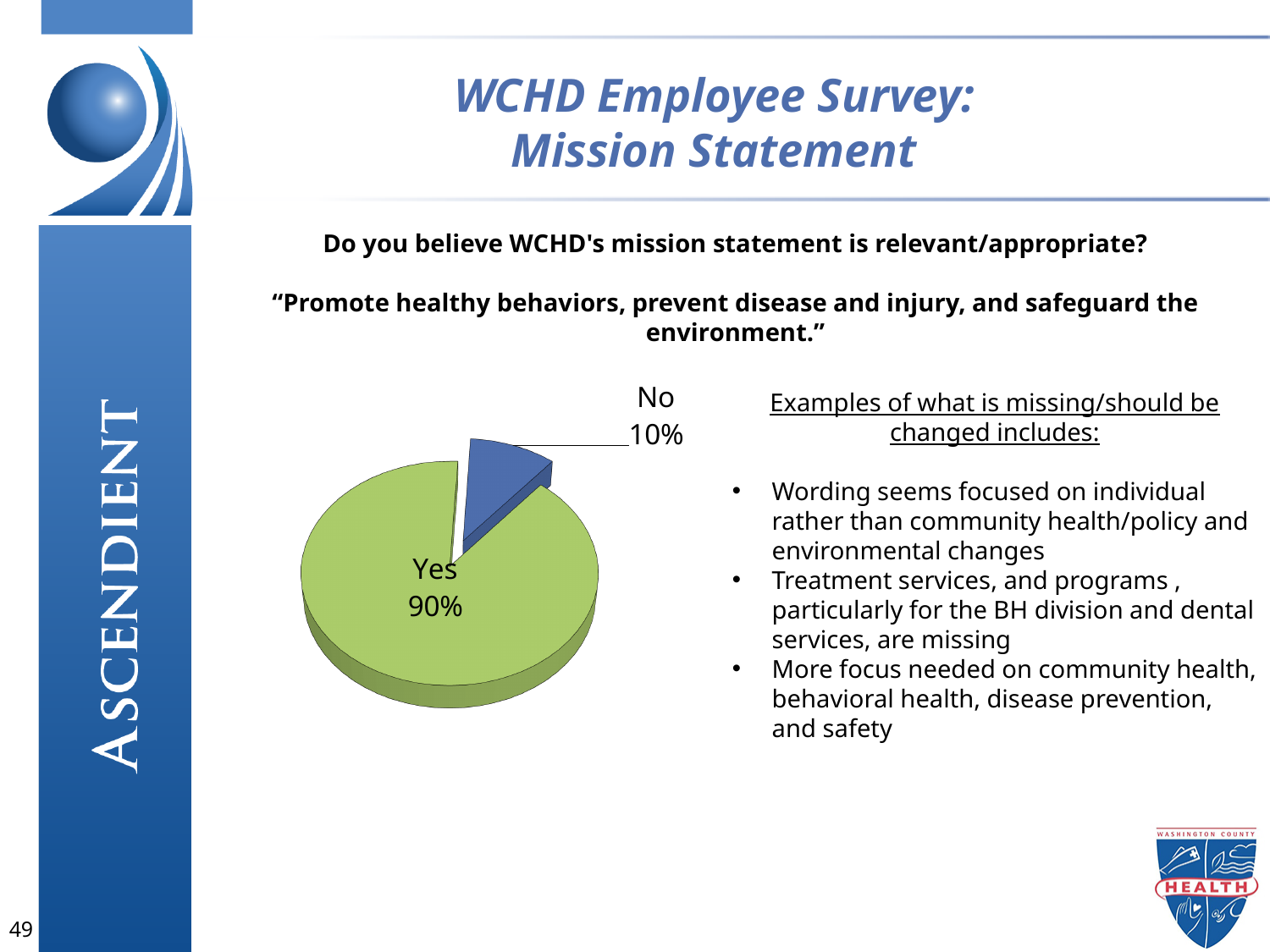
What is the difference in percentage points between the Yes and No slices? 80 What colour is the No slice of the pie chart? blue Which slice of the pie is the largest? Yes What share of the pie is labelled "Yes"? 90% What is the total of the two slices shown in the pie chart? 100% Which slice of the pie is the smallest? No Is the share for Yes greater or less than 50%? greater What colour is the Yes slice of the pie chart? green What kind of chart is shown on the slide? pie chart What share of the pie is labelled "No"? 10% Which is larger, the Yes slice or the No slice? Yes How many slices does the pie chart have? 2